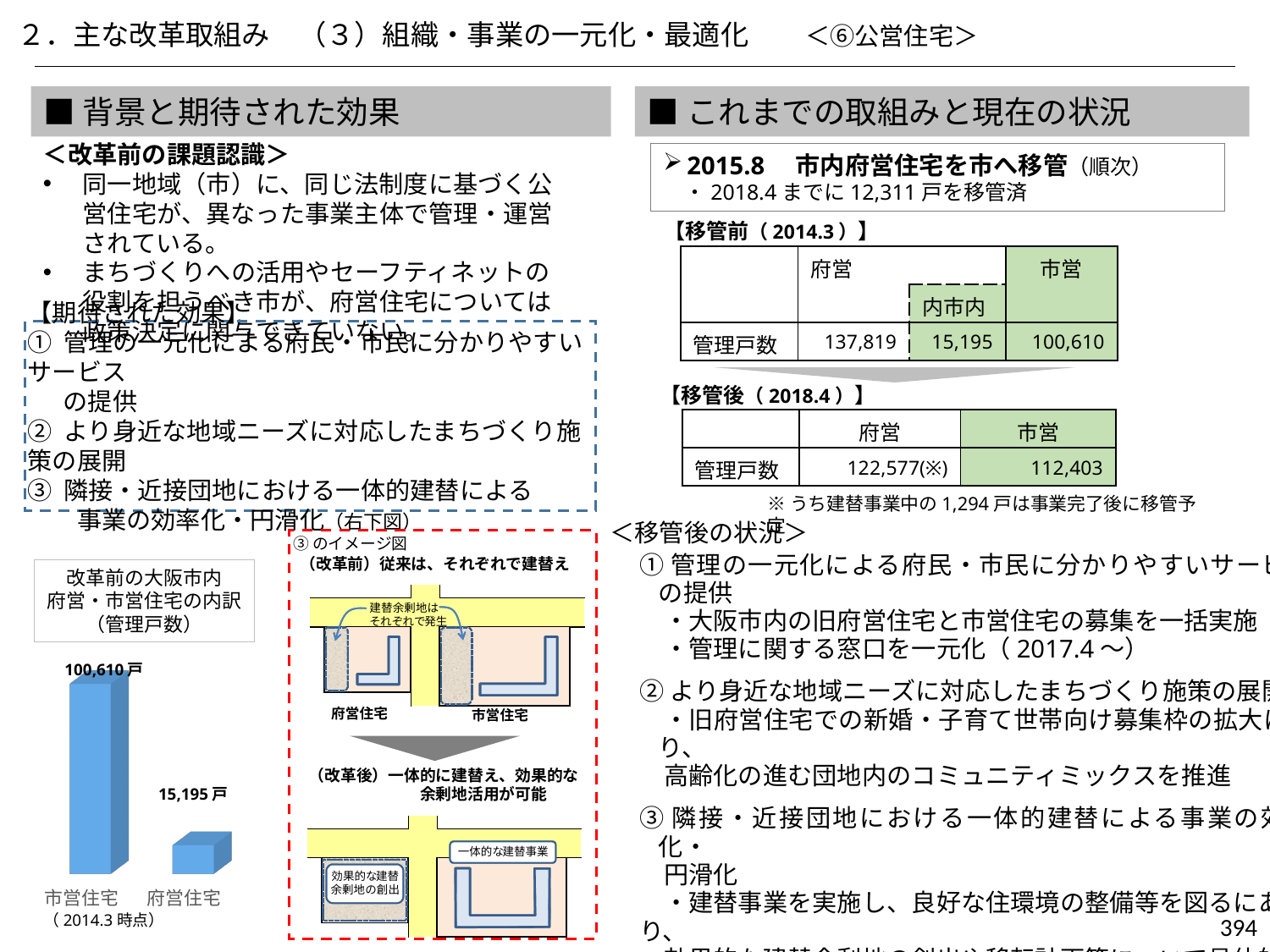
How many categories are shown in the bar chart? 2 What is the value for 市営住宅 in the bar chart? 100,610 戸 Which category has the lowest value in the bar chart? 府営住宅 What kind of chart is shown at the bottom left of the slide? Bar chart Do the values in the bar chart rise or fall from left to right? Fall Which category has the highest value in the bar chart? 市営住宅 What is the difference between the values for 市営住宅 and 府営住宅 in the bar chart? 85,415 戸 What is the value for 府営住宅 in the bar chart? 15,195 戸 As of what date are the values in the bar chart, according to the note under the category labels? 2014.3 時点 Which is larger in the bar chart, 市営住宅 or 府営住宅? 市営住宅 What is the title of the bar chart? 改革前の大阪市内 府営・市営住宅の内訳（管理戸数）